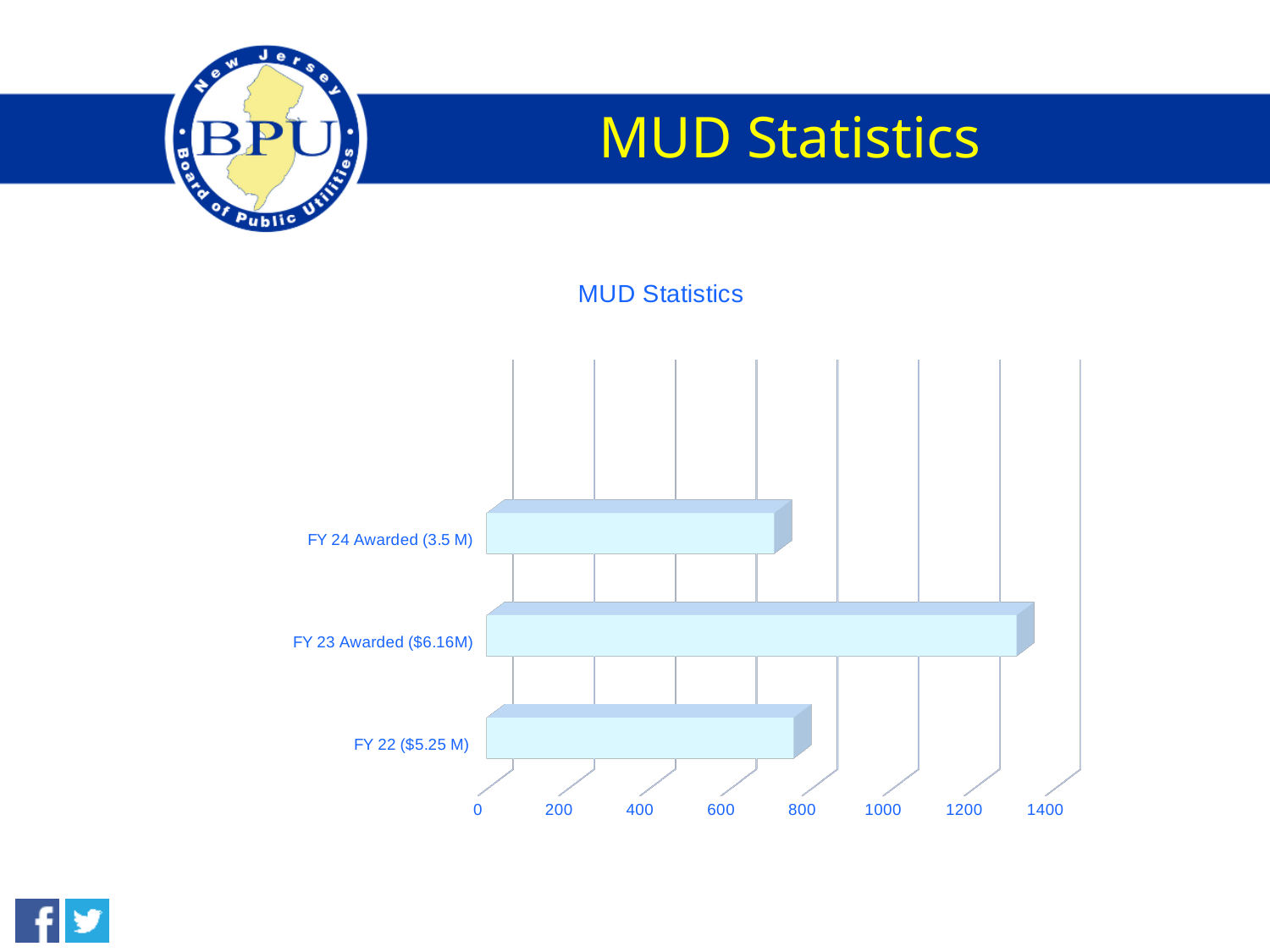
Which category has the lowest value? FY 24 Awarded (3.5 M) Is the value for FY 23 Awarded ($6.16M) greater or less than 1200? greater How many categories (bars) does the chart show? 3 Which is larger, the value for FY 23 Awarded ($6.16M) or the value for FY 24 Awarded (3.5 M)? FY 23 Awarded ($6.16M) Which category has the highest value? FY 23 Awarded ($6.16M) What kind of chart is shown on the slide? bar chart What is the highest value shown on the horizontal axis? 1400 Is the value for FY 24 Awarded (3.5 M) greater or less than 800? less Which is larger, the value for FY 23 Awarded ($6.16M) or the value for FY 22 ($5.25 M)? FY 23 Awarded ($6.16M) Is the value for FY 22 ($5.25 M) greater or less than 600? greater What is the title of the chart? MUD Statistics